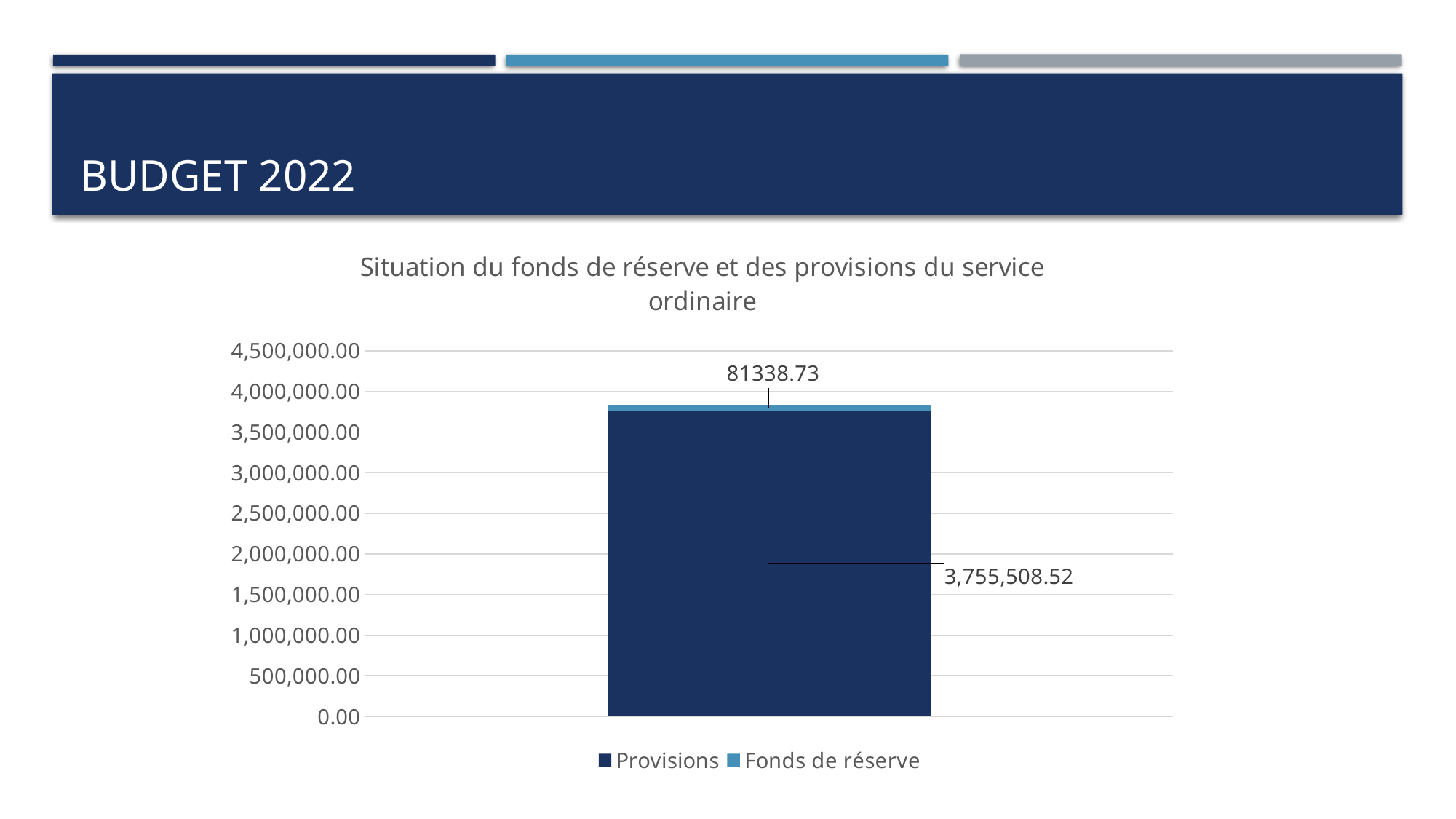
What is the difference between the Provisions value and the Fonds de réserve value? 3,674,169.79 Which series has the larger value, Provisions or Fonds de réserve? Provisions How many series does the legend list? 2 How many bars are plotted in the chart? 1 What is the title of the chart? Situation du fonds de réserve et des provisions du service ordinaire What is the value of the Fonds de réserve series in the chart? 81338.73 Is the total height of the stacked bar greater or less than 4,000,000.00? less Which series is shown in the lighter blue colour? Fonds de réserve What is the total of the stacked bar (Provisions plus Fonds de réserve)? 3,836,847.25 Which series has the smallest value in the chart? Fonds de réserve What kind of chart is shown on the slide? Stacked bar chart What is the value of the Provisions series in the chart? 3,755,508.52